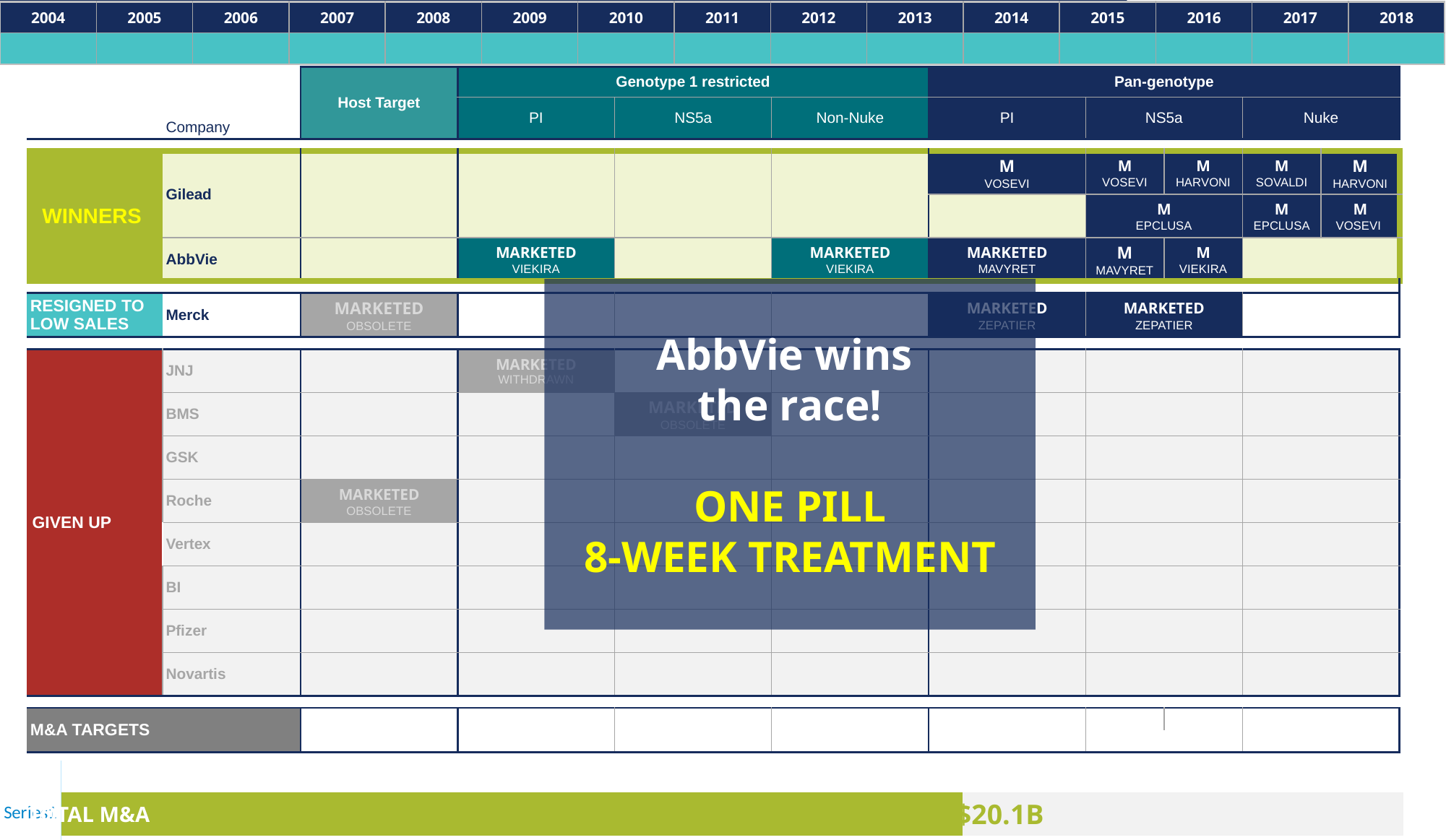
What kind of chart is shown at the bottom of the slide? bar chart What label is shown at the left end of the bar in the chart at the bottom of the slide? Series1 What value is printed on the bar in the chart at the bottom of the slide? $20.1B What colour is the bar in the chart at the bottom of the slide? green